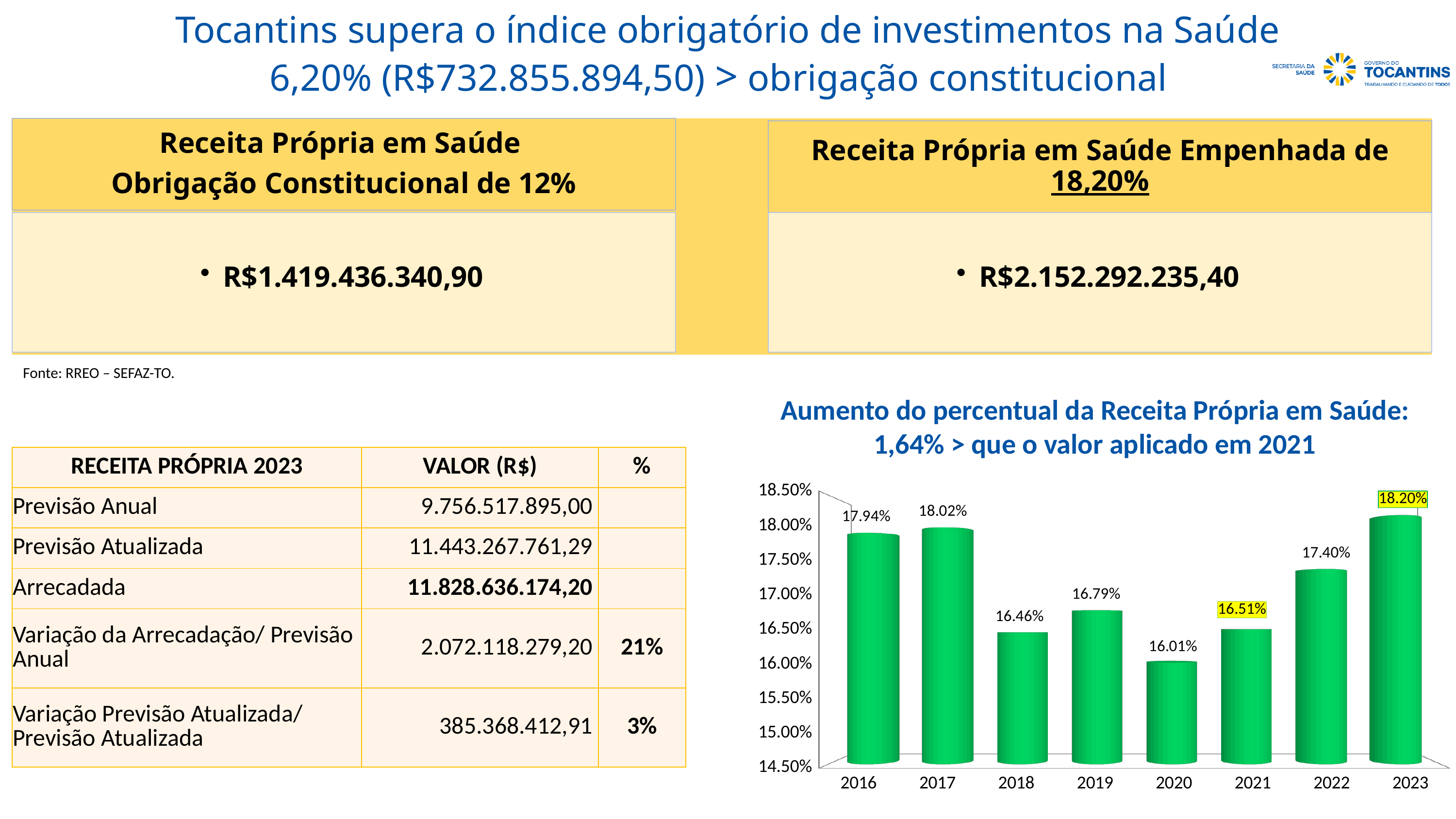
Do the values in the bar chart rise or fall from 2020 to 2023? rise What is the value shown for 2020 in the bar chart? 16.01% Which year has the highest value in the bar chart? 2023 What kind of chart is shown on the slide? bar chart Which year has the lowest value in the bar chart? 2020 What is the value shown for 2021 in the bar chart? 16.51% Which is larger in the bar chart, the value for 2019 or the value for 2022? 2022 What is the difference between the values for 2017 and 2016 in the bar chart? 0.08% Is the value for 2018 in the bar chart greater or less than 17.00%? less What is the difference between the values for 2023 and 2021 in the bar chart? 1.69% How many years are shown on the x axis of the bar chart? 8 What is the value shown for 2023 in the bar chart? 18.20%